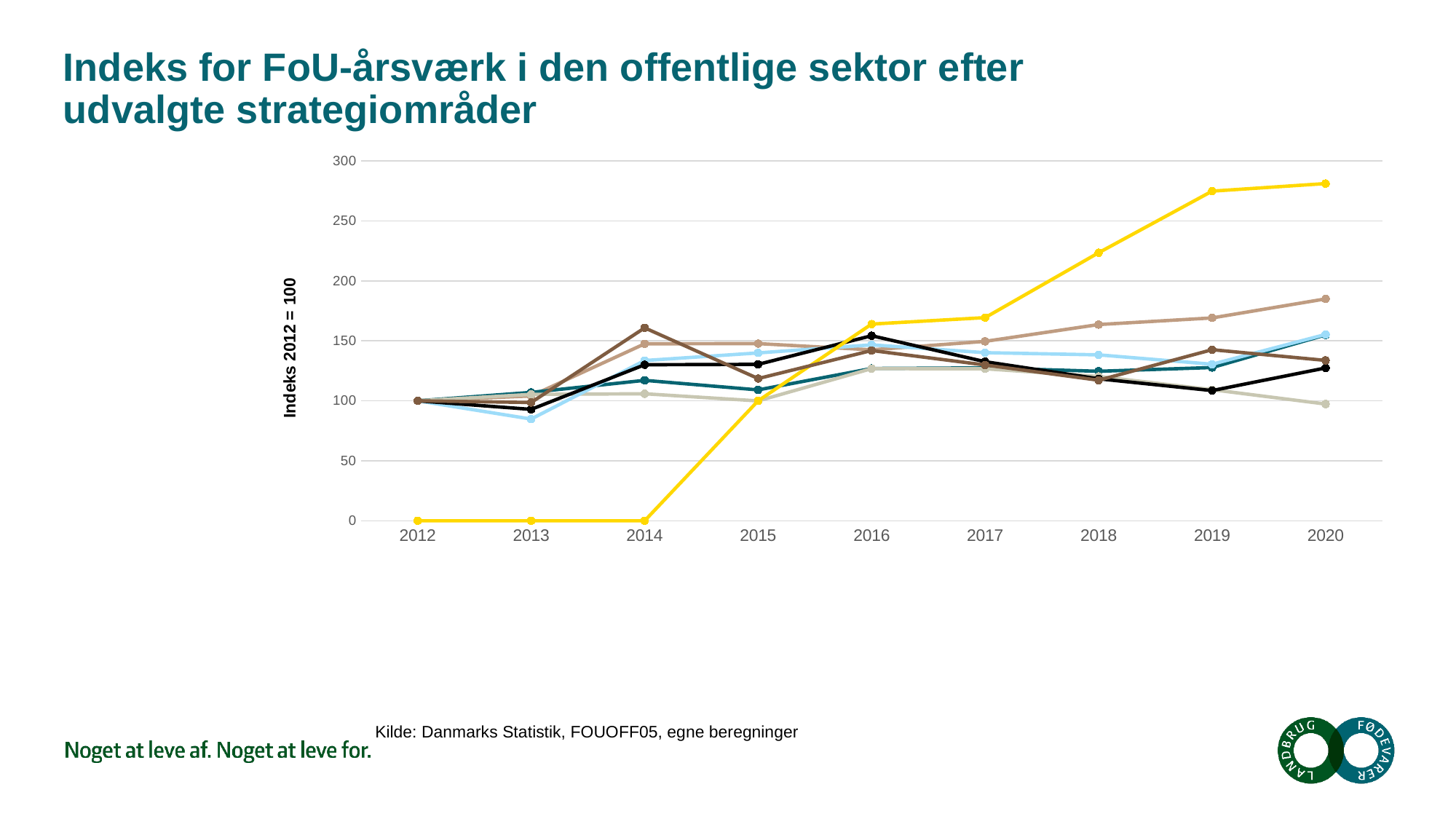
What kind of chart is shown on the slide? line chart What is the title of the chart on the slide? Indeks for FoU-årsværk i den offentlige sektor efter udvalgte strategiområder What is the label on the y axis of the chart? Indeks 2012 = 100 In 2020, which is larger: the value of the yellow line or the value of the black line? the yellow line Is the value of the yellow line in 2020 greater or less than 250? greater What is the value of the yellow line in 2013? 0 Is the value of the yellow line in 2018 greater or less than 200? greater Does the yellow line rise or fall between 2014 and 2020? rise Which coloured line has the highest value in 2020? the yellow line What is the value of the yellow line in 2014? 0 How many years are shown along the x axis of the chart? 9